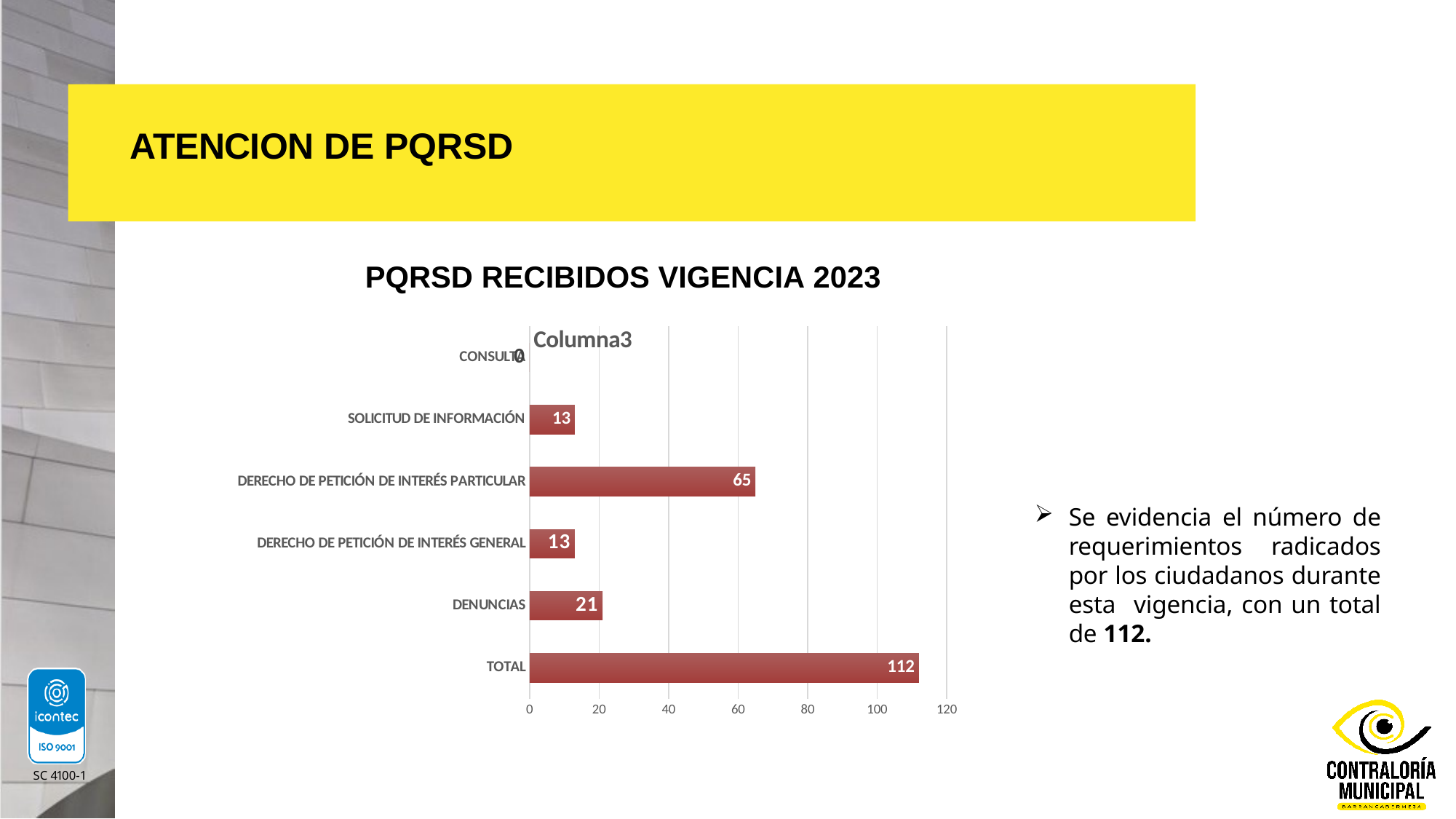
How many categories are shown on the chart? 6 What is the value for DENUNCIAS? 21 What is the value for TOTAL? 112 Which category has the lowest value? CONSULTA What kind of chart is shown? Bar chart What is the value for CONSULTA? 0 Excluding the TOTAL bar, which category has the highest value? DERECHO DE PETICIÓN DE INTERÉS PARTICULAR What is the value for DERECHO DE PETICIÓN DE INTERÉS PARTICULAR? 65 What is the value for SOLICITUD DE INFORMACIÓN? 13 What is the difference between DERECHO DE PETICIÓN DE INTERÉS PARTICULAR and DENUNCIAS? 44 Which is larger, DENUNCIAS or DERECHO DE PETICIÓN DE INTERÉS GENERAL? DENUNCIAS What is the title of the chart? PQRSD RECIBIDOS VIGENCIA 2023